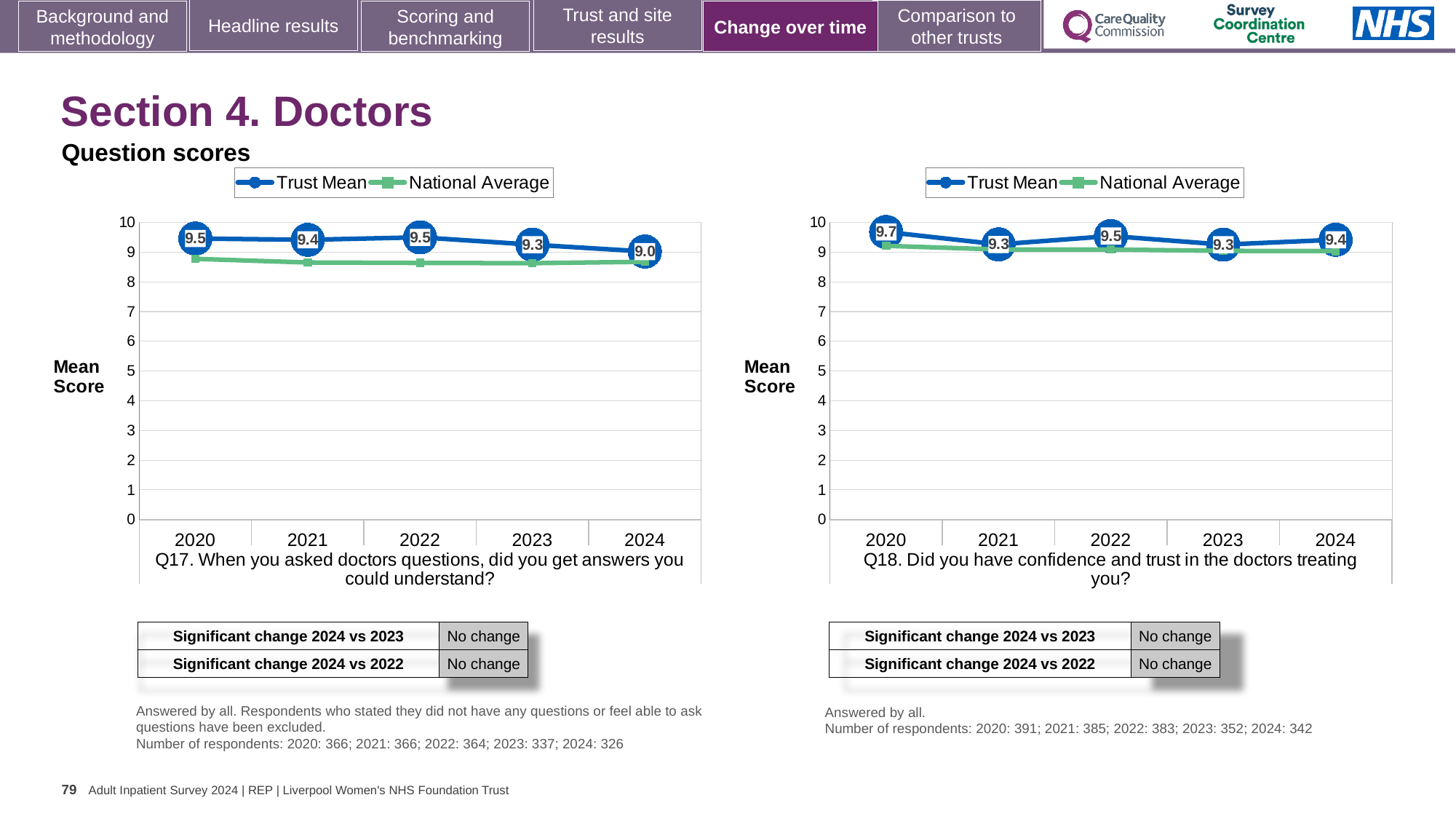
In the Q17 chart (left), which year has the lowest Trust Mean score? 2024 What type of chart is used for Q17 (left)? Line chart In the Q17 chart (left), what is the Trust Mean score for 2024? 9.0 In the Q17 chart (left), does the Trust Mean score rise or fall from 2022 to 2024? Fall In the Q17 chart (left), what is the difference between the Trust Mean scores for 2022 and 2024? 0.5 In the Q18 chart (right), what is the Trust Mean score for 2020? 9.7 In the Q18 chart (right), which year has the highest Trust Mean score? 2020 How many series does the legend of the Q18 chart (right) list? 2 In the Q18 chart (right), what is the difference between the Trust Mean scores for 2020 and 2021? 0.4 In the Q17 chart (left), is the National Average value for 2020 greater or less than 8? greater In the Q18 chart (right), is the Trust Mean score higher in 2022 or in 2023? 2022 How many years are shown on the x axis of the Q17 chart (left)? 5